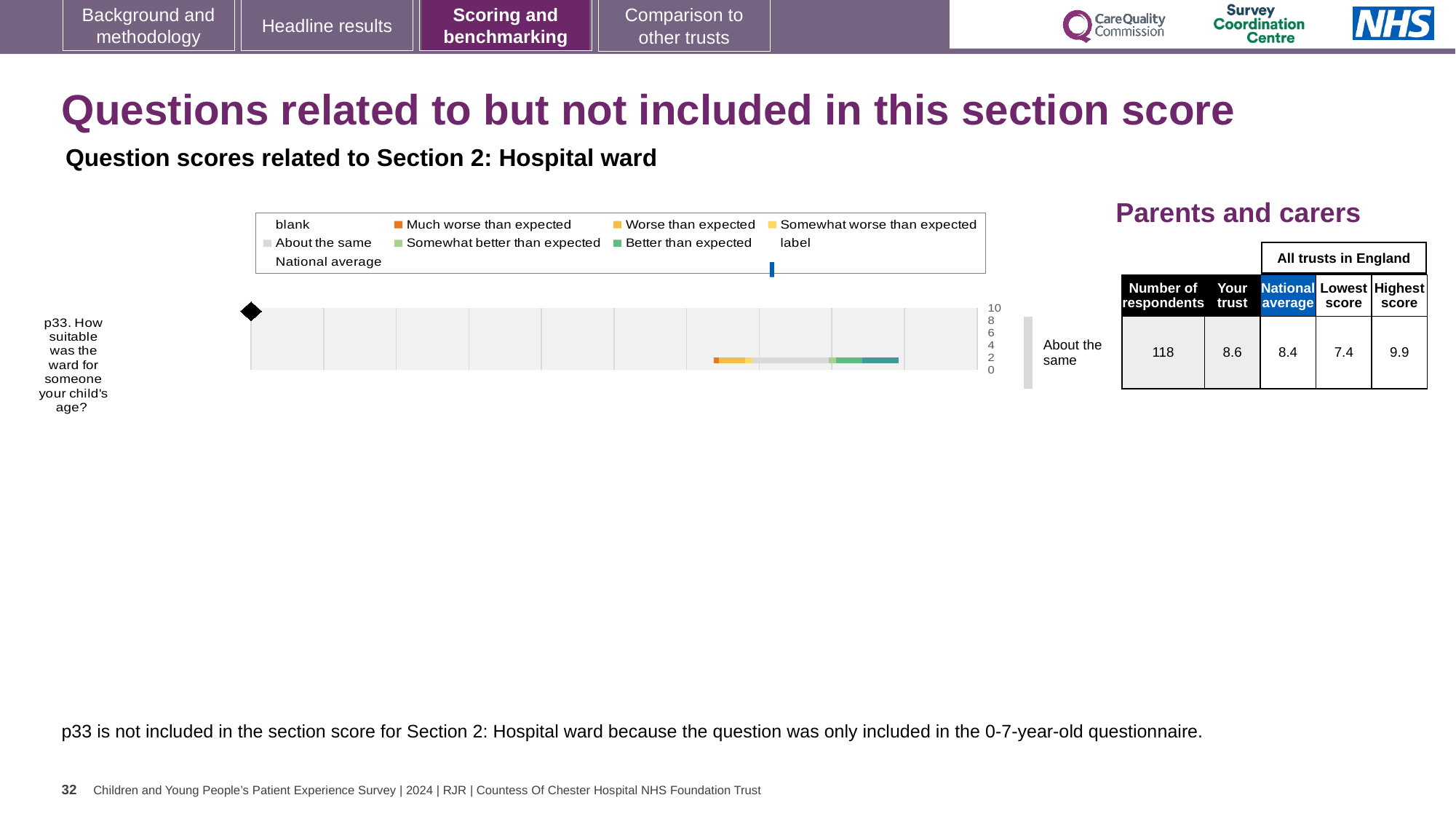
How many questions (categories) are plotted in the chart? 1 How many respondents answered p33? 118 What is the lowest score among all trusts in England for p33? 7.4 What is the national average score for p33 in the table? 8.4 What is the highest score among all trusts in England for p33? 9.9 What benchmark category label is shown to the right of the bar for p33? About the same What colour does the legend use for 'Much worse than expected'? orange Which is larger for p33, the 'Your trust' score or the national average? Your trust What is the difference between the highest score and the lowest score for p33? 2.5 What kind of chart is shown on the slide? bar chart Which question is plotted in the chart? p33. How suitable was the ward for someone your child's age? What is the 'Your trust' score for p33 in the table? 8.6